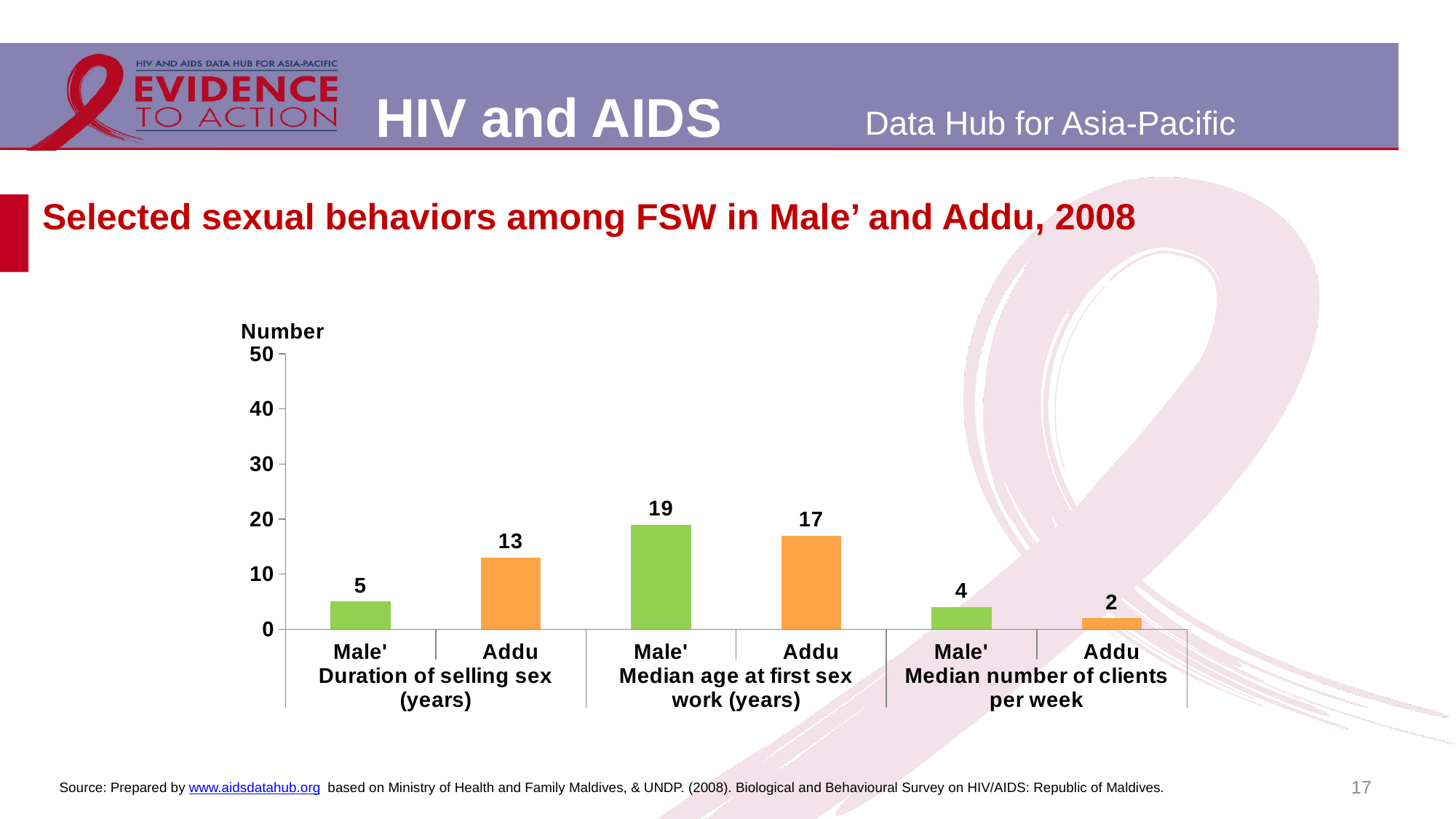
Which is larger: the median number of clients per week for Male' or for Addu? Male' What is the difference between the Addu and Male' values for Duration of selling sex (years)? 8 What is the median number of clients per week for Addu? 2 What is the value for Addu under Duration of selling sex (years)? 13 How many bars are plotted in the chart? 6 Which bar has the lowest value in the chart? Addu Median number of clients per week What is the label on the vertical axis of the chart? Number What is the median age at first sex work (years) for Male'? 19 What is the value for Male' under Duration of selling sex (years)? 5 Which bar has the highest value in the chart? Male' Median age at first sex work (years) What type of chart is shown on the slide? Bar chart What is the median age at first sex work (years) for Addu? 17